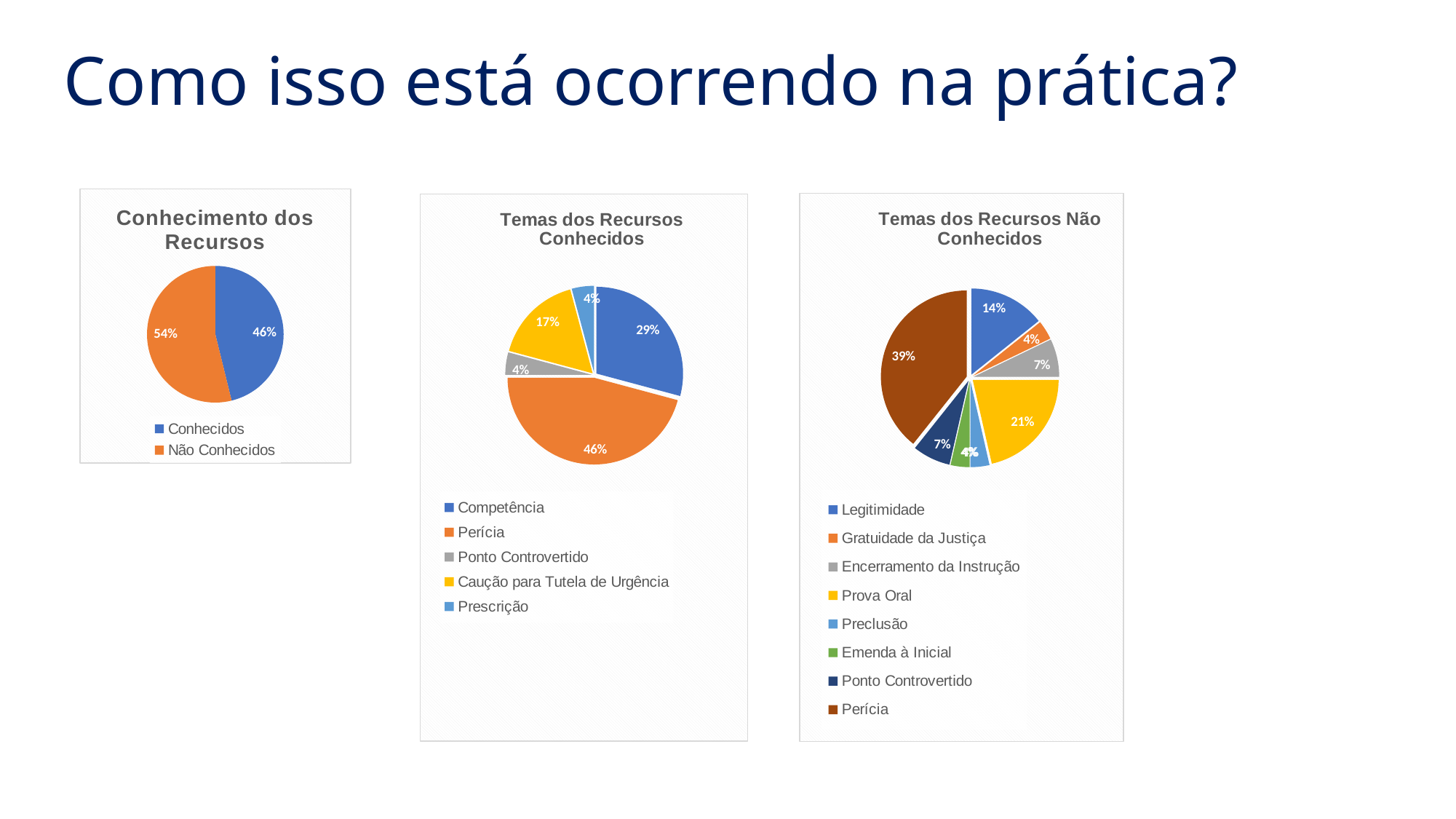
What type of chart is 'Temas dos Recursos Não Conhecidos'? Pie chart In the 'Temas dos Recursos Não Conhecidos' chart, what share is 'Perícia'? 39% In the 'Conhecimento dos Recursos' chart, which slice is larger, 'Conhecidos' or 'Não Conhecidos'? Não Conhecidos In the 'Temas dos Recursos Não Conhecidos' chart, what share is 'Prova Oral'? 21% In the 'Temas dos Recursos Conhecidos' chart, what share is 'Perícia'? 46% How many categories does the legend of the 'Temas dos Recursos Conhecidos' chart list? 5 In the 'Conhecimento dos Recursos' chart, what share is 'Não Conhecidos'? 54% In the 'Conhecimento dos Recursos' chart, what share is 'Conhecidos'? 46% In the 'Temas dos Recursos Conhecidos' chart, what share is 'Caução para Tutela de Urgência'? 17% In the 'Temas dos Recursos Não Conhecidos' chart, which is larger, 'Legitimidade' or 'Prova Oral'? Prova Oral In the 'Temas dos Recursos Conhecidos' chart, what is the difference between the shares of 'Perícia' and 'Competência'? 17% In the 'Temas dos Recursos Conhecidos' chart, which category has the largest share? Perícia